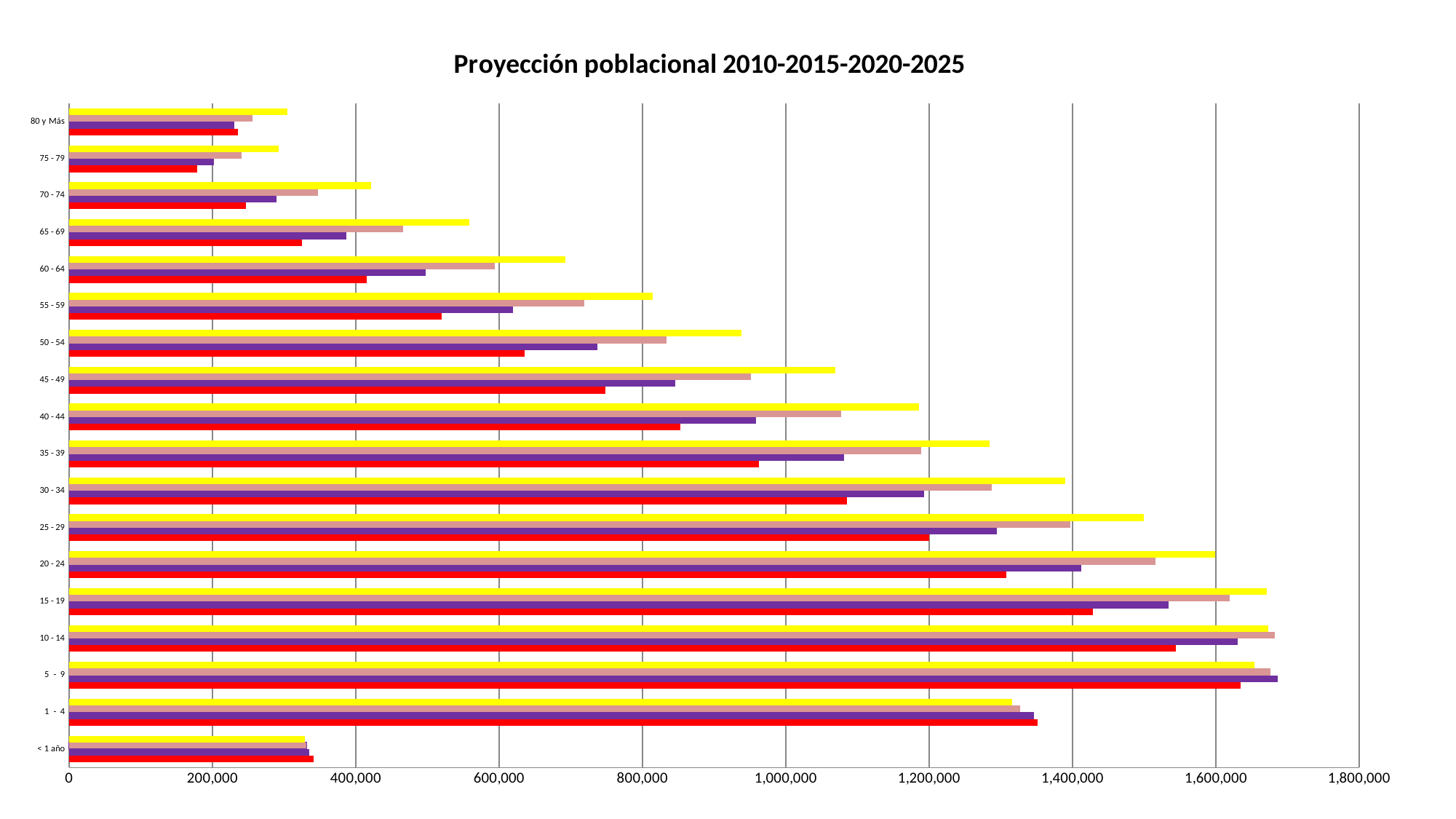
How many bars are plotted for each age-group category? 4 Is the yellow bar for 45 - 49 greater or less than 1,000,000? greater Which age group has the longest red bar? 5 - 9 How many age-group categories are shown on the chart? 18 Is the red bar for 75 - 79 greater or less than 200,000? less Is the yellow bar for 80 y Más greater or less than 400,000? less Which is longer, the yellow bar for 20 - 24 or the yellow bar for 25 - 29? 20 - 24 What is the title of the chart? Proyección poblacional 2010-2015-2020-2025 Which age group has the shortest red bar? 75 - 79 What kind of chart is shown on the slide? bar chart